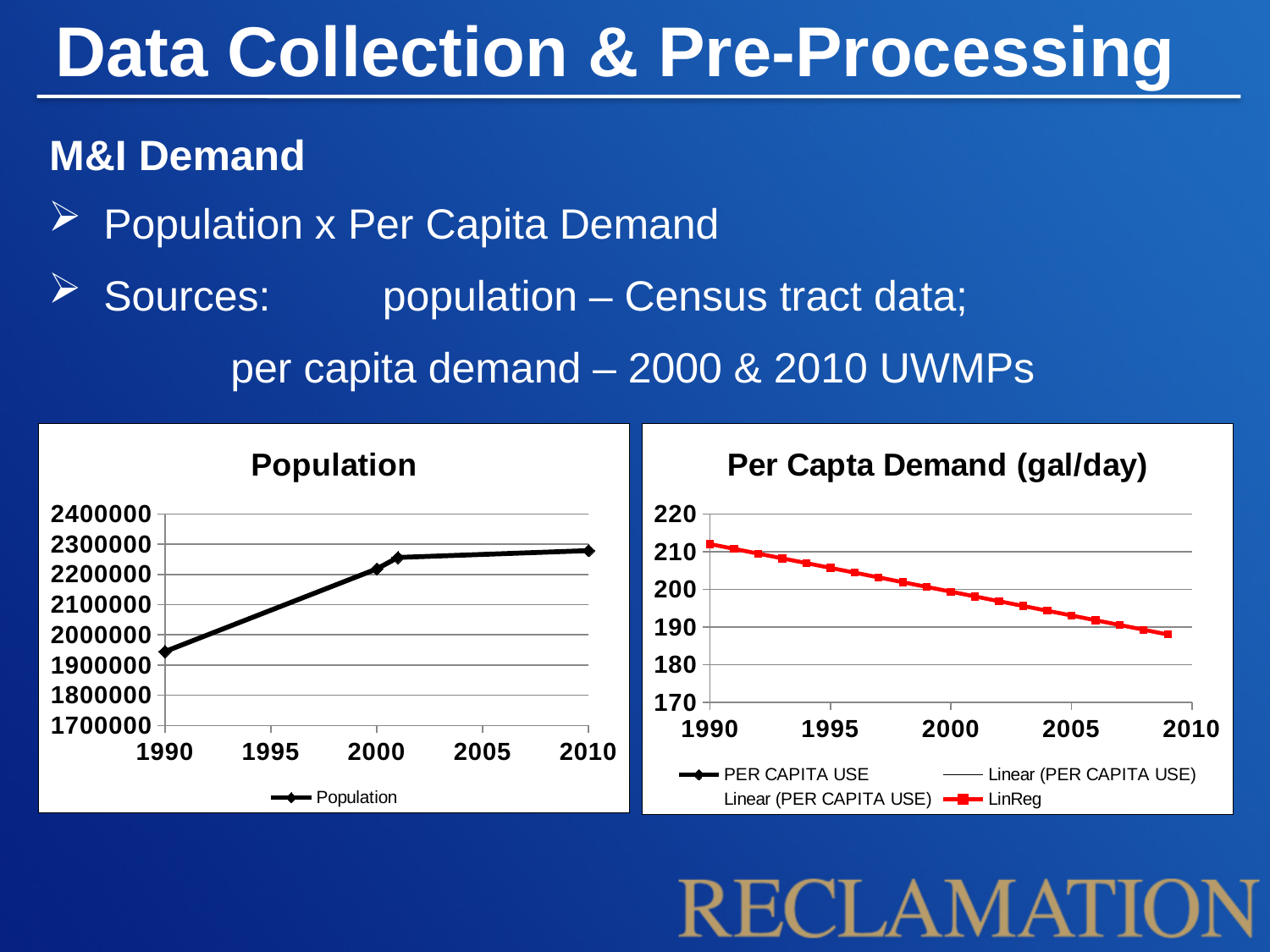
How many entries does the legend of the Per Capta Demand (gal/day) chart list? 4 How many series does the legend of the Population chart list? 1 In the Per Capta Demand (gal/day) chart, does the LinReg line rise or fall from 1990 to 2010? fall What kind of chart is the Population chart? line chart What is the title of the chart on the right side of the slide? Per Capta Demand (gal/day) In the Population chart, do the values rise or fall from 1990 to 2010? rise In the Per Capta Demand (gal/day) chart, is the LinReg value for 1990 greater or less than 210? greater In the Population chart, is the value for 2010 greater or less than 2200000? greater In the Per Capta Demand (gal/day) chart, which year has the larger LinReg value, 1990 or 2005? 1990 In the Population chart, which year has the larger value, 1990 or 2010? 2010 In the Population chart, is the value for 1990 greater or less than 2000000? less